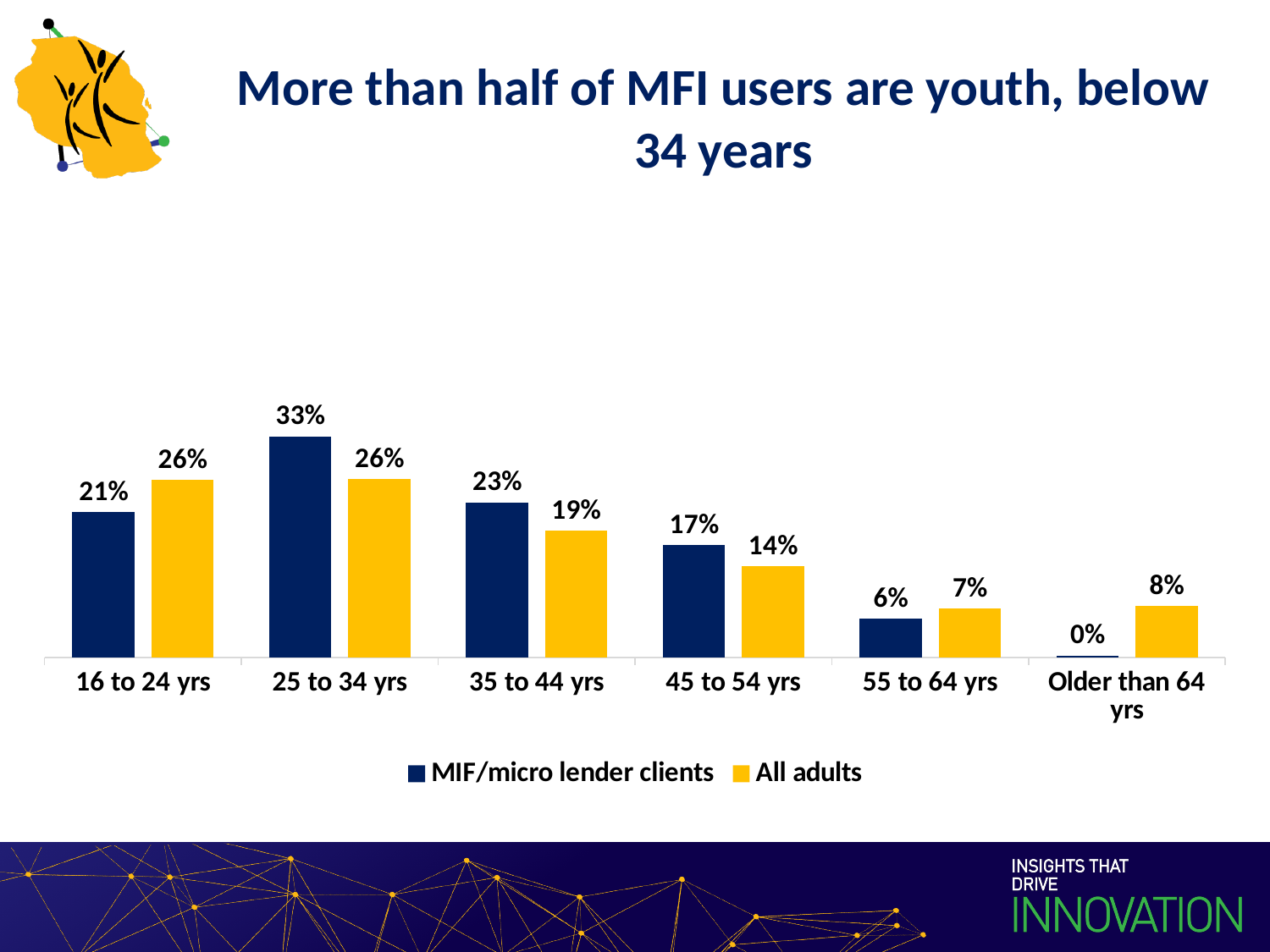
From the 25 to 34 yrs category onward, do the values for MIF/micro lender clients rise or fall along the x axis? Fall What is the difference between MIF/micro lender clients and All adults in the 25 to 34 yrs category? 7% What is the value for All adults in the 45 to 54 yrs category? 14% In the 16 to 24 yrs category, which series has the larger value: MIF/micro lender clients or All adults? All adults How many series does the legend list? 2 What kind of chart is shown on the slide? Bar chart What colour are the bars for All adults? Yellow What is the value for MIF/micro lender clients in the Older than 64 yrs category? 0% How many age categories are shown on the x axis? 6 What percentage of MIF/micro lender clients are aged 25 to 34 yrs? 33% Which age group has the lowest value for All adults? 55 to 64 yrs Which age group has the highest value for MIF/micro lender clients? 25 to 34 yrs